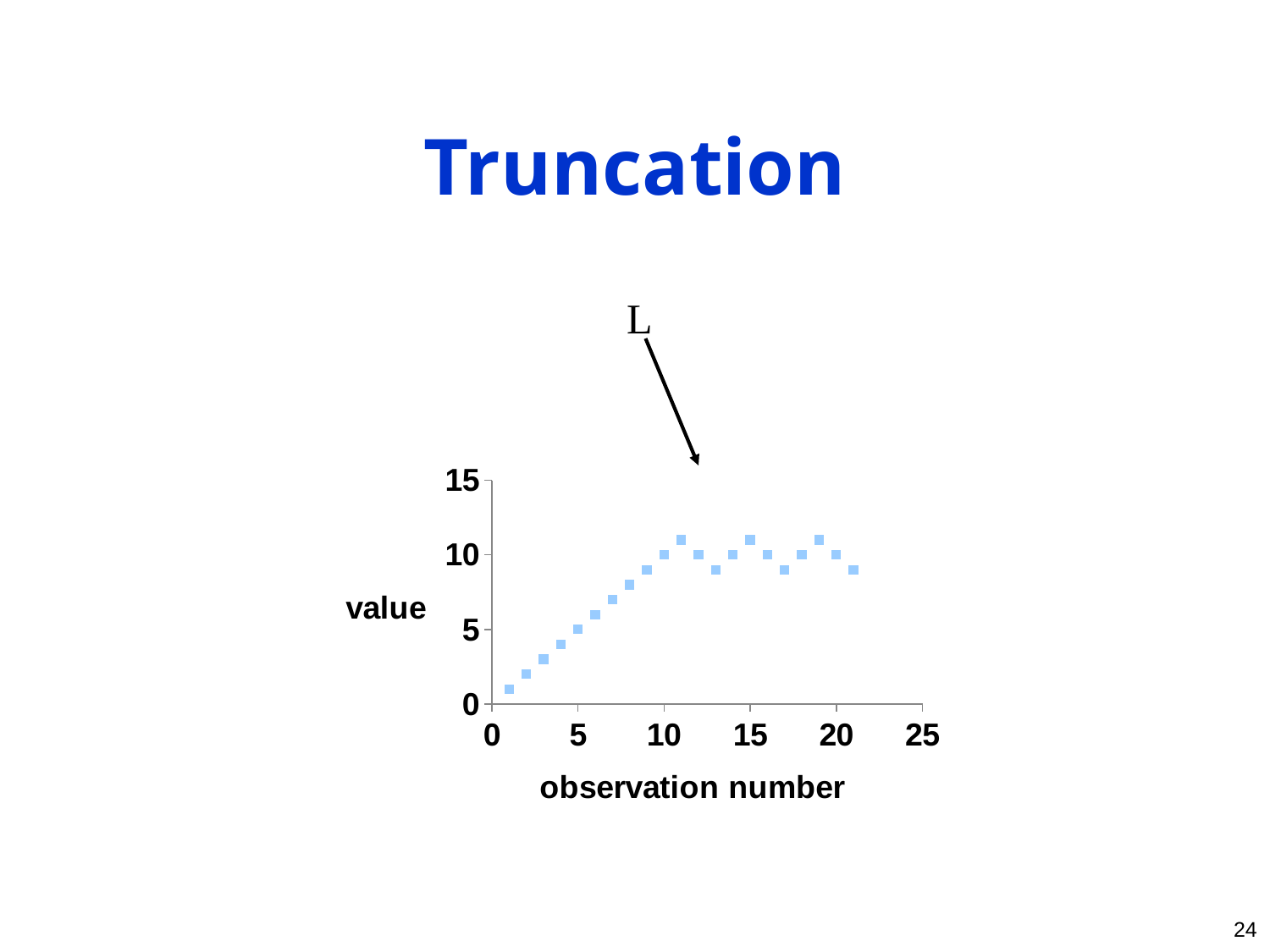
What is the highest tick value shown on the y axis? 15 What kind of chart is shown on the slide? scatter chart How many data points are plotted on the chart? 21 Is the value for observation number 1 greater or less than 5? less What is the title of the slide containing the chart? Truncation Is the value for observation number 3 greater or less than 5? less Is the value for observation number 20 greater or less than 5? greater Which is larger, the value for observation number 2 or the value for observation number 8? observation number 8 What is the label of the x axis of the chart? observation number Do the values rise or fall from observation number 1 to observation number 10? rise